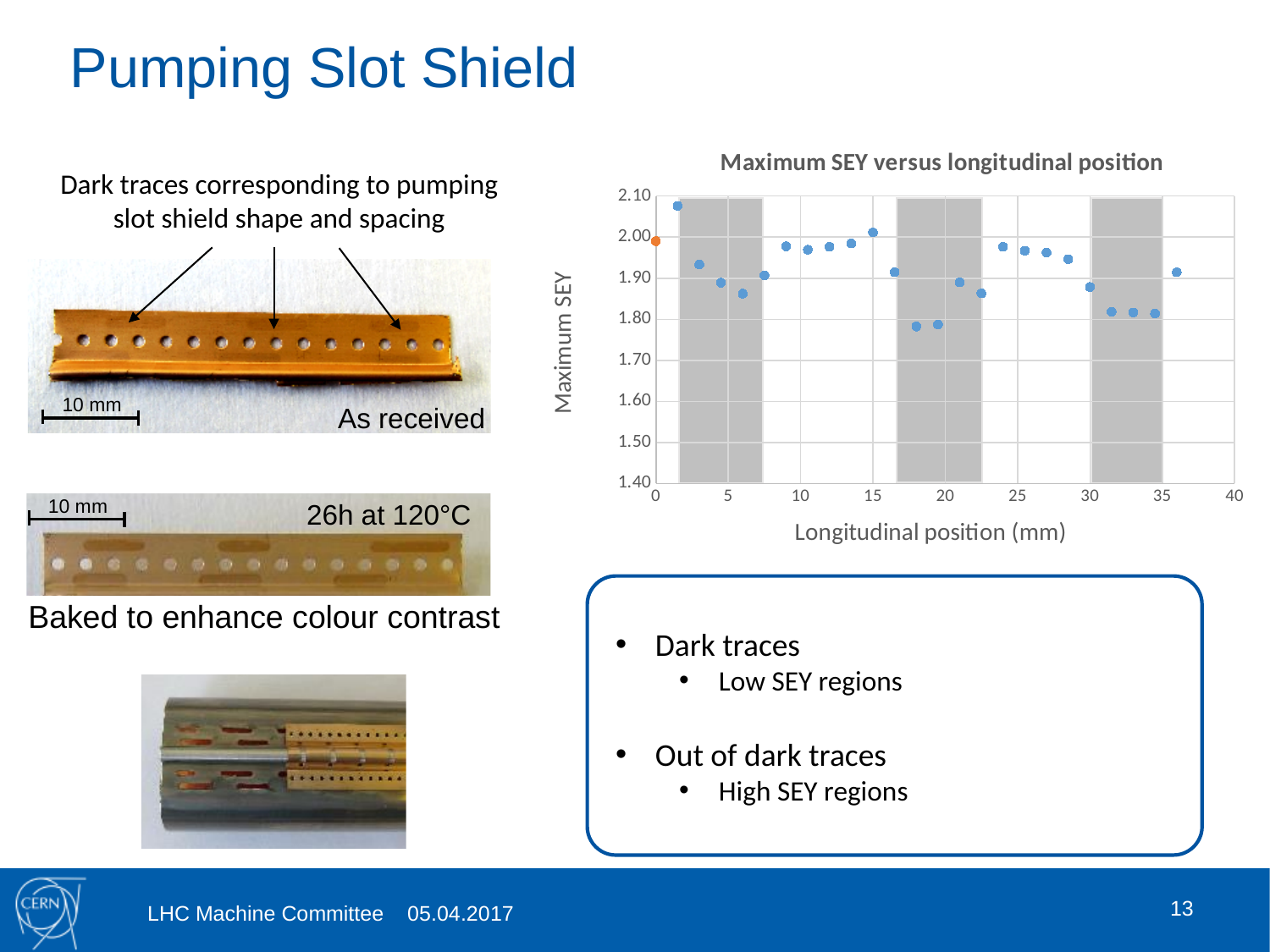
Is the highest point in the chart located near the left end or the right end of the x axis? Left end Do the values rise or fall between about 1.5 mm and 6 mm on the x axis? fall What kind of chart is shown on the slide? Scatter chart Is the value of the point at about 9 mm greater or less than 1.90? greater Is the lowest plotted value in the chart greater or less than 1.70? greater What is the label of the vertical axis of the chart? Maximum SEY Is the value of the point at about 33 mm greater or less than 1.90? less Which has the larger Maximum SEY: the point at about 1.5 mm or the point at about 18 mm? The point at about 1.5 mm Do the values rise or fall between about 19.5 mm and 24 mm on the x axis? rise What is the title of the chart? Maximum SEY versus longitudinal position